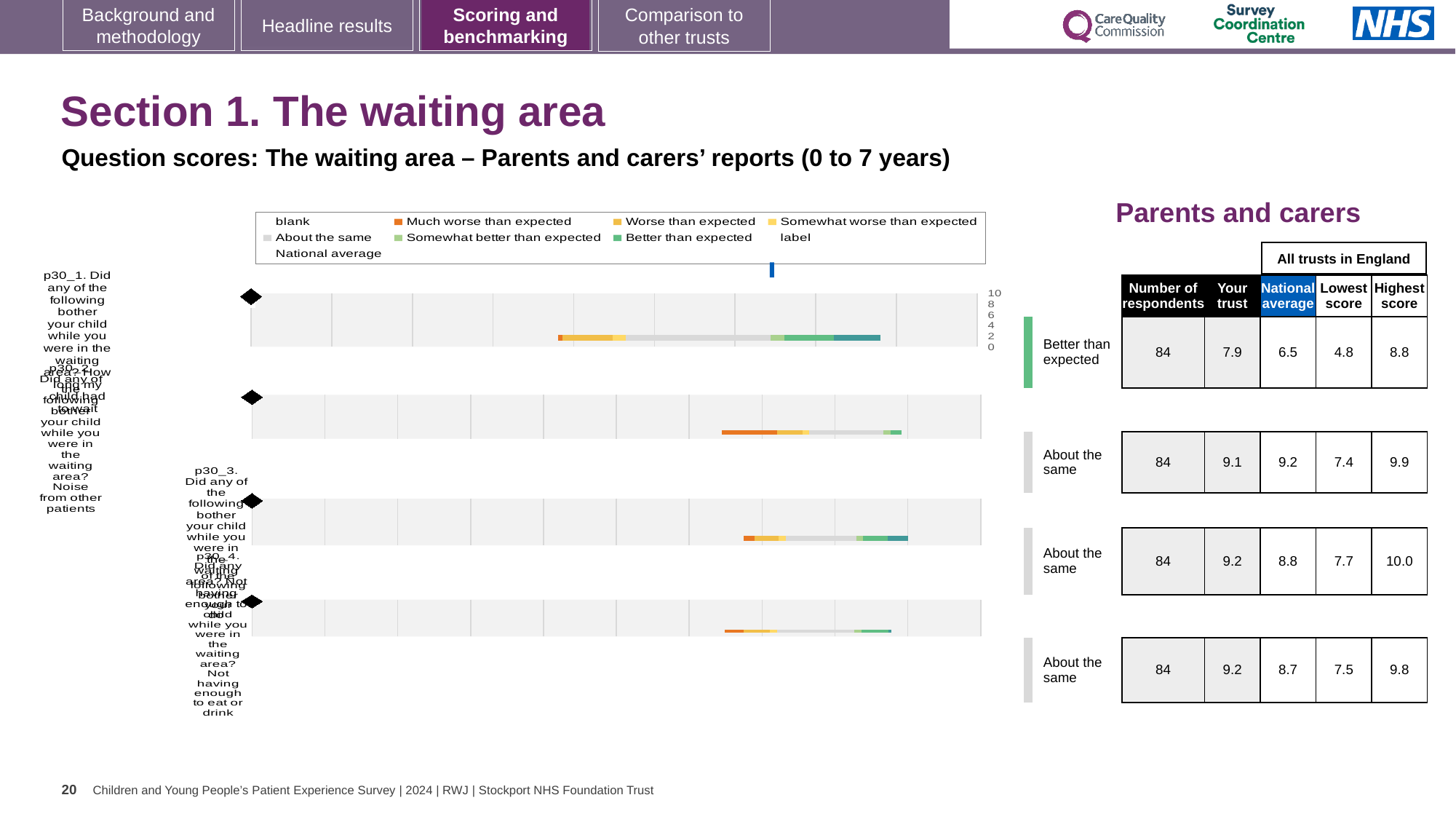
In the table beside the chart, which row has the lowest 'Your trust' score? Better than expected (first row) What kind of chart is shown on the slide? bar chart In the table beside the chart, what is the number of respondents shown in the first row (Better than expected)? 84 In the table beside the chart, what is the difference between the highest score and the lowest score in the first row (Better than expected)? 4.0 In the table beside the chart, what is the 'Your trust' score in the first row (Better than expected)? 7.9 How many entries does the chart legend list? 9 How many question bars are plotted in the chart? 4 Which question label appears at the top of the chart? p30_1 In the table beside the chart, which is larger in the first row: the 'Your trust' score or the national average? Your trust In the table beside the chart, what is the national average in the first row (Better than expected)? 6.5 Which colour represents 'Much worse than expected' in the chart legend? orange In the table beside the chart, what is the highest score in the third row? 10.0